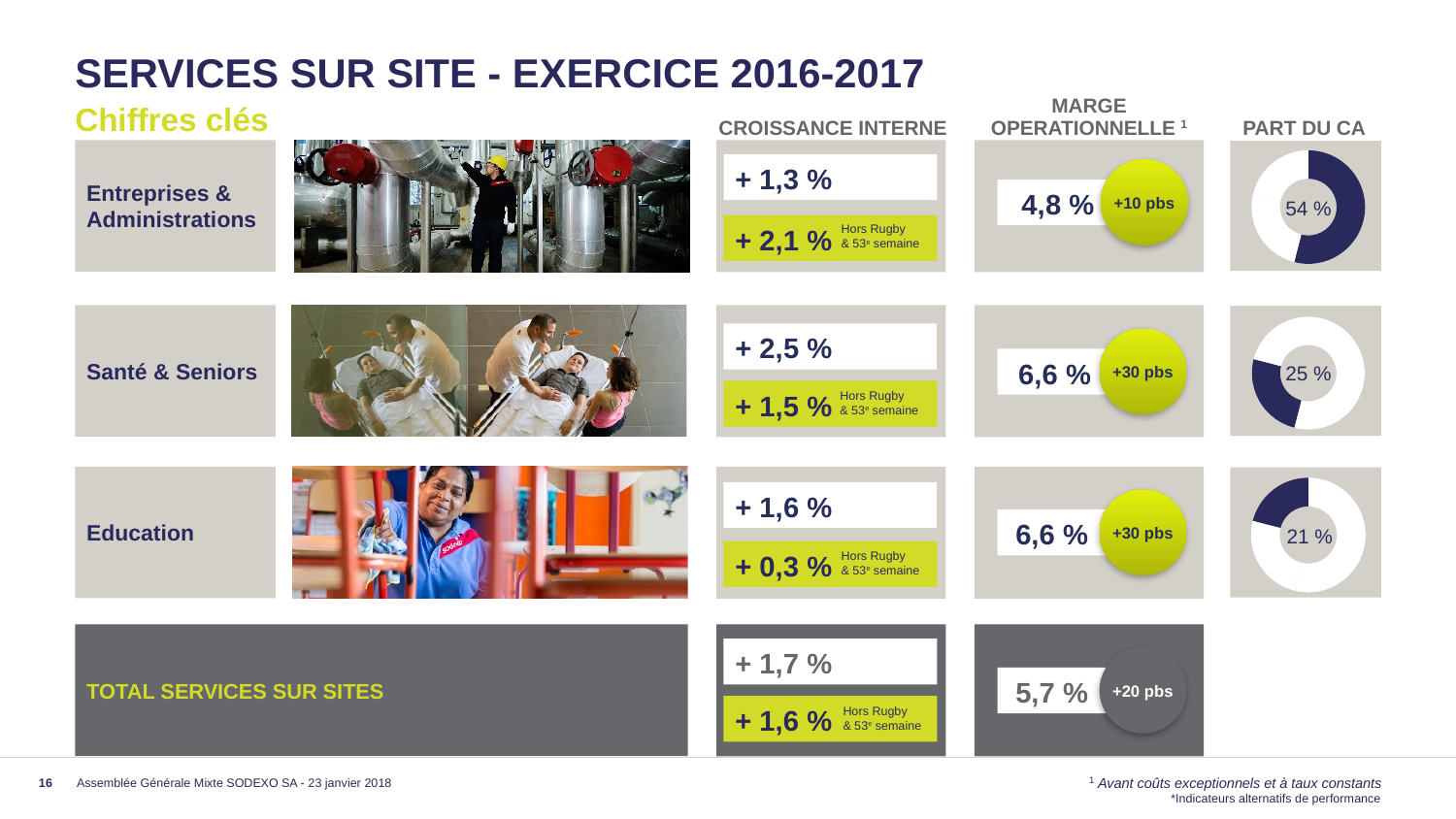
What is the difference between the PART DU CA shares of Entreprises & Administrations and Education? 33 % In the PART DU CA donut chart for Entreprises & Administrations, what share is shown? 54 % What is the difference between the PART DU CA shares of Entreprises & Administrations and Santé & Seniors? 29 % What type of chart is used in the PART DU CA column? Donut (pie) chart In the PART DU CA donut chart for Education, what share is shown? 21 % Among the three PART DU CA donut charts, which segment has the smallest share of revenue? Education Looking at the PART DU CA donut charts, which segment has a larger share: Santé & Seniors or Education? Santé & Seniors What is the difference between the PART DU CA shares of Santé & Seniors and Education? 4 % What is the sum of the three PART DU CA shares shown in the donut charts? 100 % In the PART DU CA donut chart for Santé & Seniors, what share is shown? 25 % Among the three PART DU CA donut charts, which segment has the largest share of revenue? Entreprises & Administrations How many PART DU CA donut charts are shown on the slide? 3